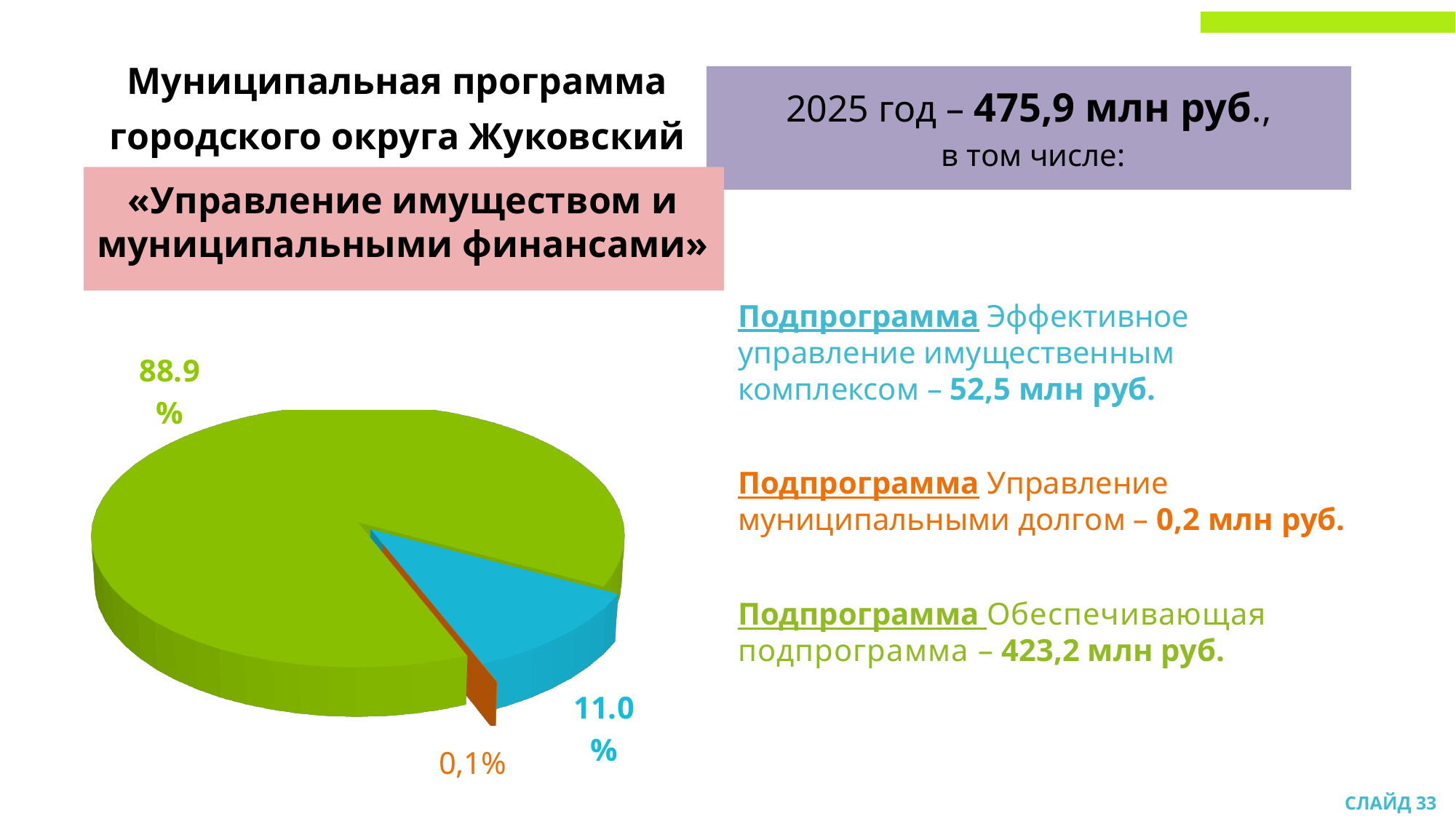
How many slices does the pie chart have? 3 What is the difference in percentage points between the green slice and the blue slice of the pie chart? 77.9 What percentage is shown for the green slice of the pie chart? 88.9% What share of the pie does the slice for the Обеспечивающая подпрограмма (green) represent? 88.9% What kind of chart is shown on the slide? pie chart Which slice of the pie chart is the largest? the green slice (88.9%) What colour is the slice representing the subprogram Эффективное управление имущественным комплексом? blue Which slice of the pie chart is the smallest? the orange slice (0,1%) What percentage is shown for the orange slice of the pie chart? 0,1% What colour is the slice representing the subprogram Управление муниципальными долгом? orange What percentage is shown for the blue slice of the pie chart? 11.0% Which is larger in the pie chart, the blue slice or the orange slice? the blue slice